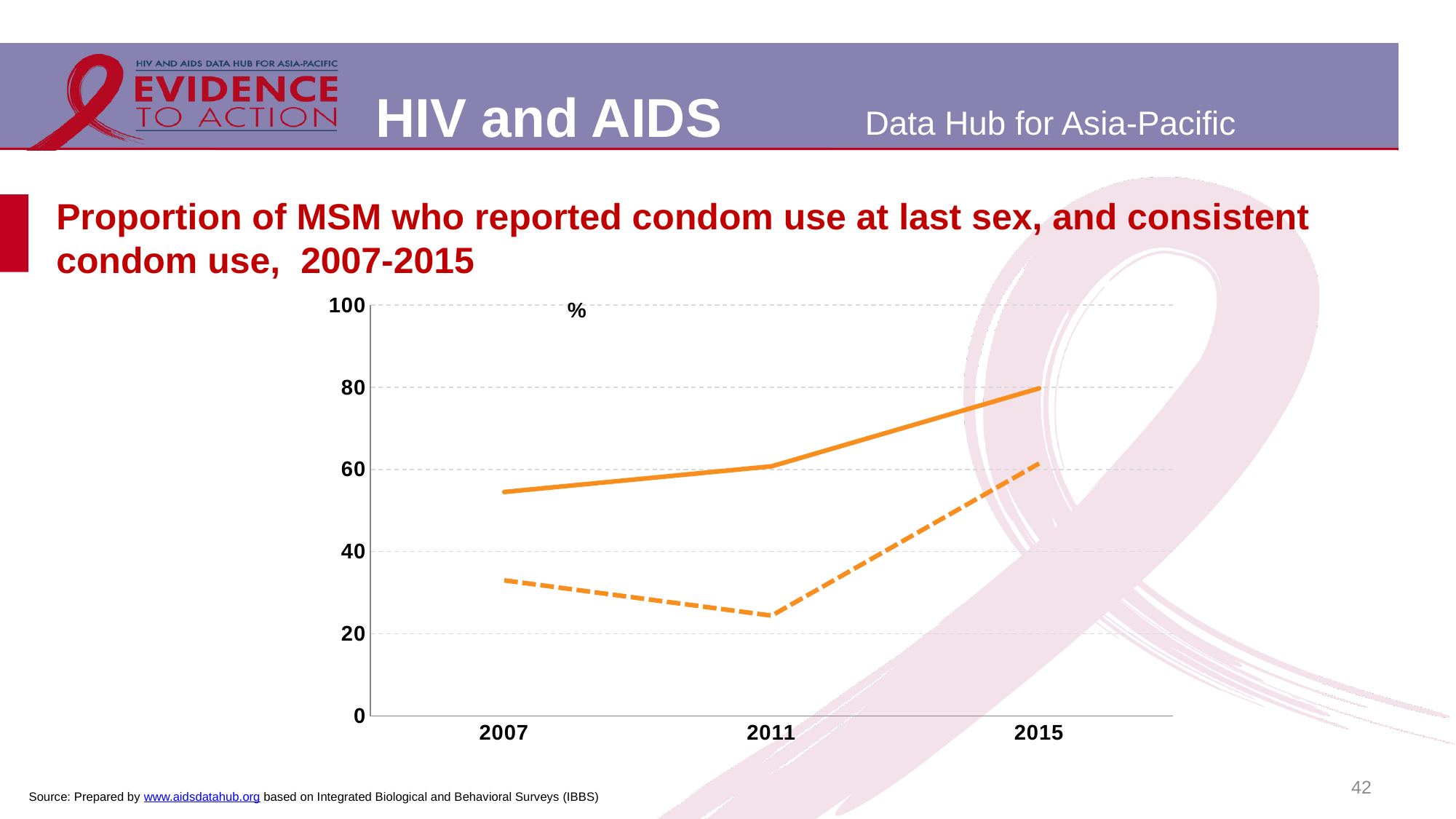
Is the value of the dashed line in 2011 greater or less than 40? less Is the value of the dashed line in 2015 greater or less than 40? greater In which year does the solid line reach its highest value? 2015 Is the value of the dashed line in 2007 greater or less than 40? less What unit is shown at the top of the y axis of the chart? % In 2015, which line has the higher value, the solid line or the dashed line? the solid line In which year does the dashed line reach its lowest value? 2011 Does the solid line rise or fall from 2007 to 2015? rises What kind of chart is shown on the slide? line chart How many years are plotted along the x axis of the chart? 3